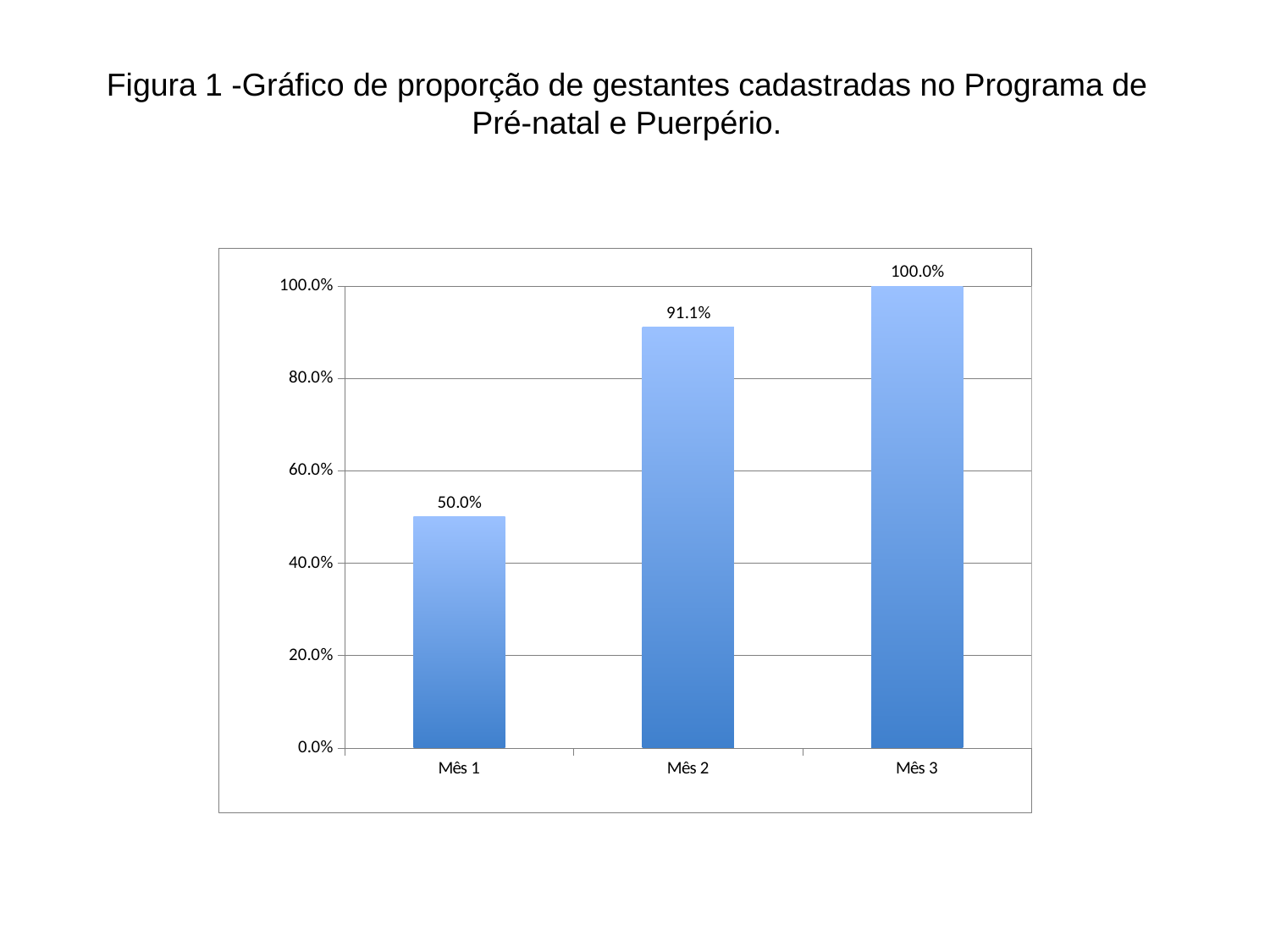
What is the value for Mês 1? 50.0% What kind of chart is shown on the slide? Bar chart What is the difference between the values for Mês 2 and Mês 1? 41.1% Do the values rise or fall from Mês 1 to Mês 3? Rise What is the difference between the values for Mês 3 and Mês 1? 50.0% Is the value for Mês 2 greater or less than 80.0%? greater What is the value for Mês 2? 91.1% Which month has the lowest value? Mês 1 What is the value for Mês 3? 100.0% Which is larger, the value for Mês 1 or the value for Mês 2? Mês 2 How many categories are shown on the x axis? 3 Which month has the highest value? Mês 3